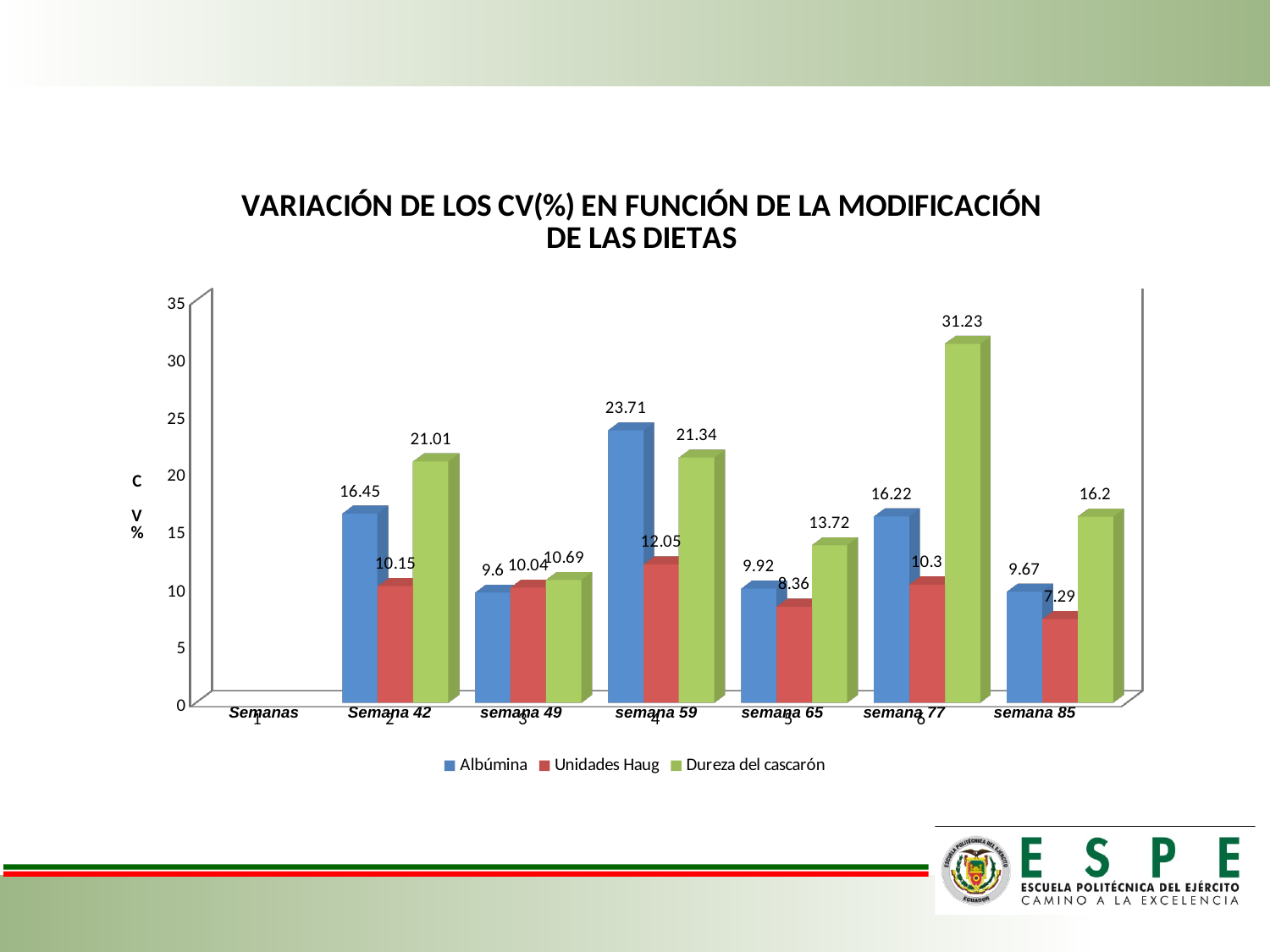
What is the value of Albúmina for semana 59? 23.71 What is the value of Dureza del cascarón for semana 77? 31.23 What is the value of Unidades Haug for semana 85? 7.29 In which week is the Unidades Haug value lowest? semana 85 Which is larger for semana 59: Albúmina or Dureza del cascarón? Albúmina What kind of chart is shown on the slide? Bar chart How many series does the legend list? 3 What is the difference between the Dureza del cascarón value and the Albúmina value for semana 77? 15.01 In which week is the Dureza del cascarón value highest? semana 77 Which series is shown in green in the legend? Dureza del cascarón Is the Dureza del cascarón value for semana 77 greater or less than 30? greater What is the value of Unidades Haug for Semana 42? 10.15